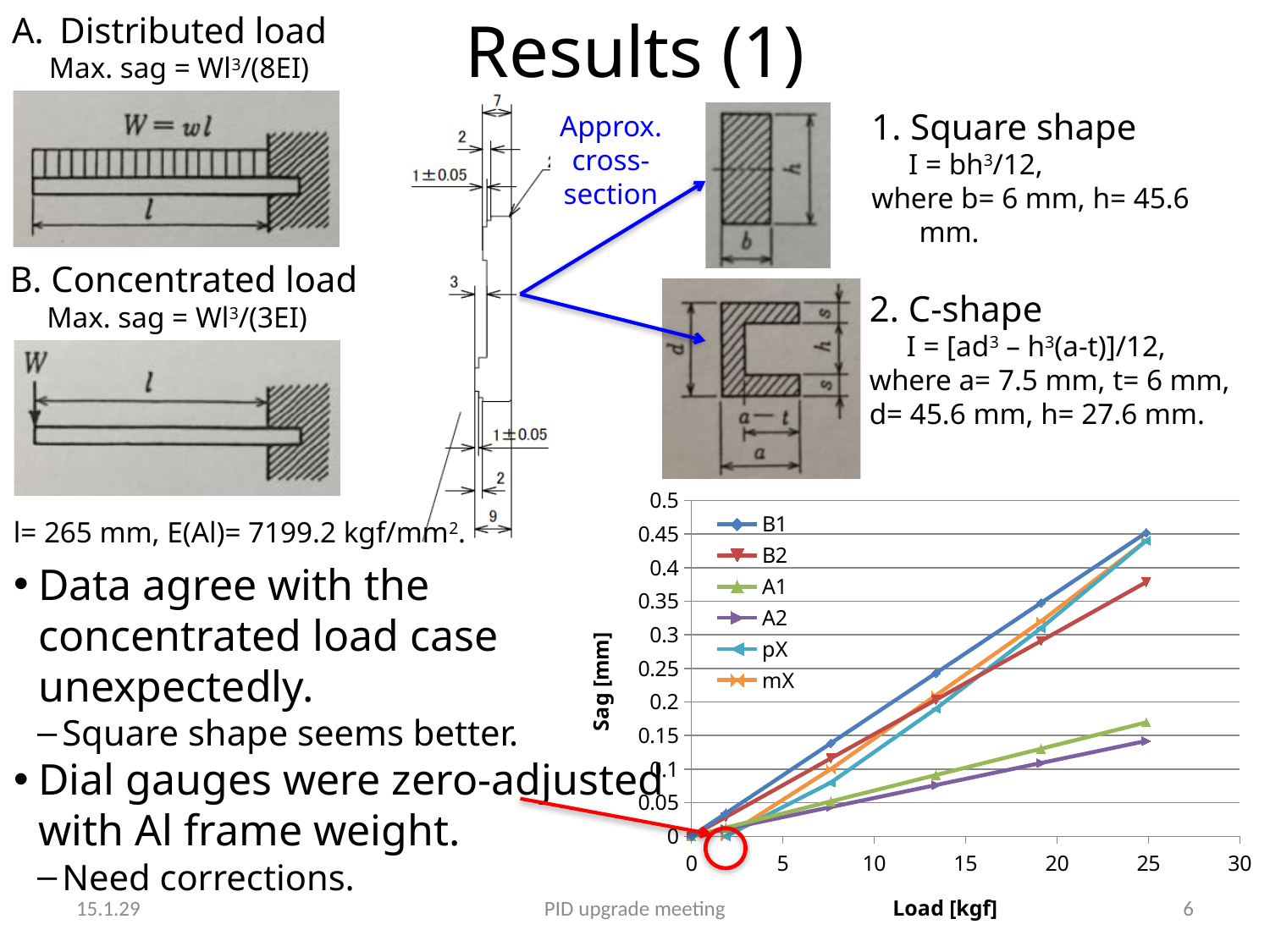
What kind of chart is shown on the slide? line chart What is the label of the chart's x axis? Load [kgf] Which series has the lowest sag at a load of 25 kgf? A2 Is the sag for B2 at a load of 25 kgf greater or less than 0.4 mm? less Does the sag rise or fall as the load increases along the x axis? rise At a load of 25 kgf, which series has the larger sag, B2 or A1? B2 Is the sag for B1 at a load of 25 kgf greater or less than 0.4 mm? greater Is the sag for A2 at a load of 25 kgf greater or less than 0.1 mm? greater At a load of 25 kgf, which series has the larger sag, B1 or A2? B1 How many series does the chart legend list? 6 What are the series names listed in the chart legend? B1, B2, A1, A2, pX, mX